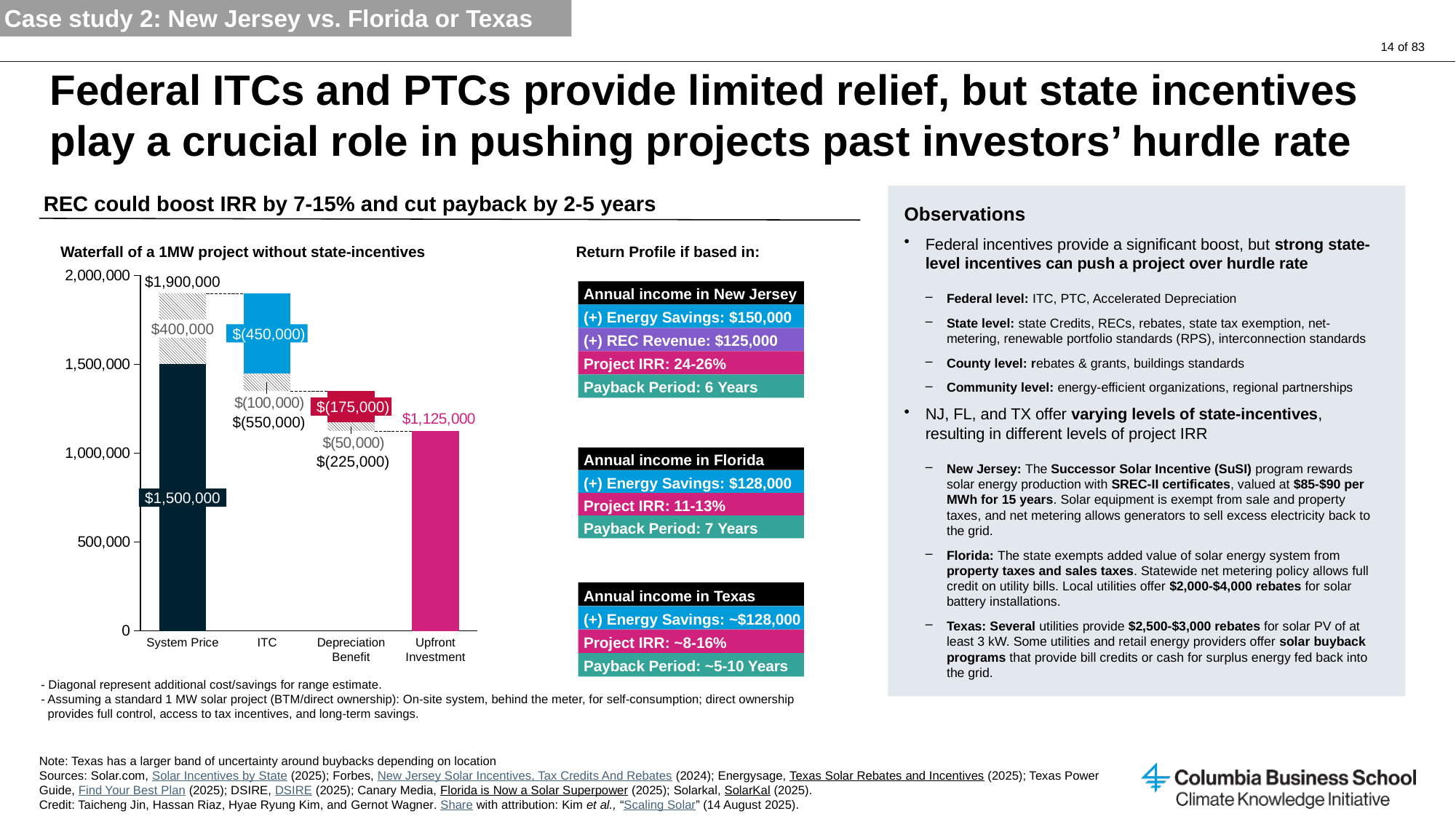
In the waterfall chart, what is the combined ITC reduction label shown below the ITC bar (including the diagonal range)? $(550,000) In the waterfall chart, is the value for Upfront Investment greater or less than 1,000,000? greater How many categories are shown on the x axis of the waterfall chart? 4 In the waterfall chart, which is larger: the System Price bar or the Upfront Investment bar? System Price What kind of chart is the 'Waterfall of a 1MW project without state-incentives'? bar chart What is the title of the chart on the left of the slide? Waterfall of a 1MW project without state-incentives In the waterfall chart, what is the value labelled on the Upfront Investment bar? $1,125,000 In the waterfall chart, what is the difference between the System Price ($1,500,000) and the Upfront Investment ($1,125,000)? $375,000 In the waterfall chart, what value is labelled at the top of the diagonal range above the System Price bar? $1,900,000 In the waterfall chart, what value is printed on the solid Depreciation Benefit bar? $(175,000) In the waterfall chart, what is the value labelled on the System Price bar? $1,500,000 In the waterfall chart, what value is printed on the solid ITC bar? $(450,000)